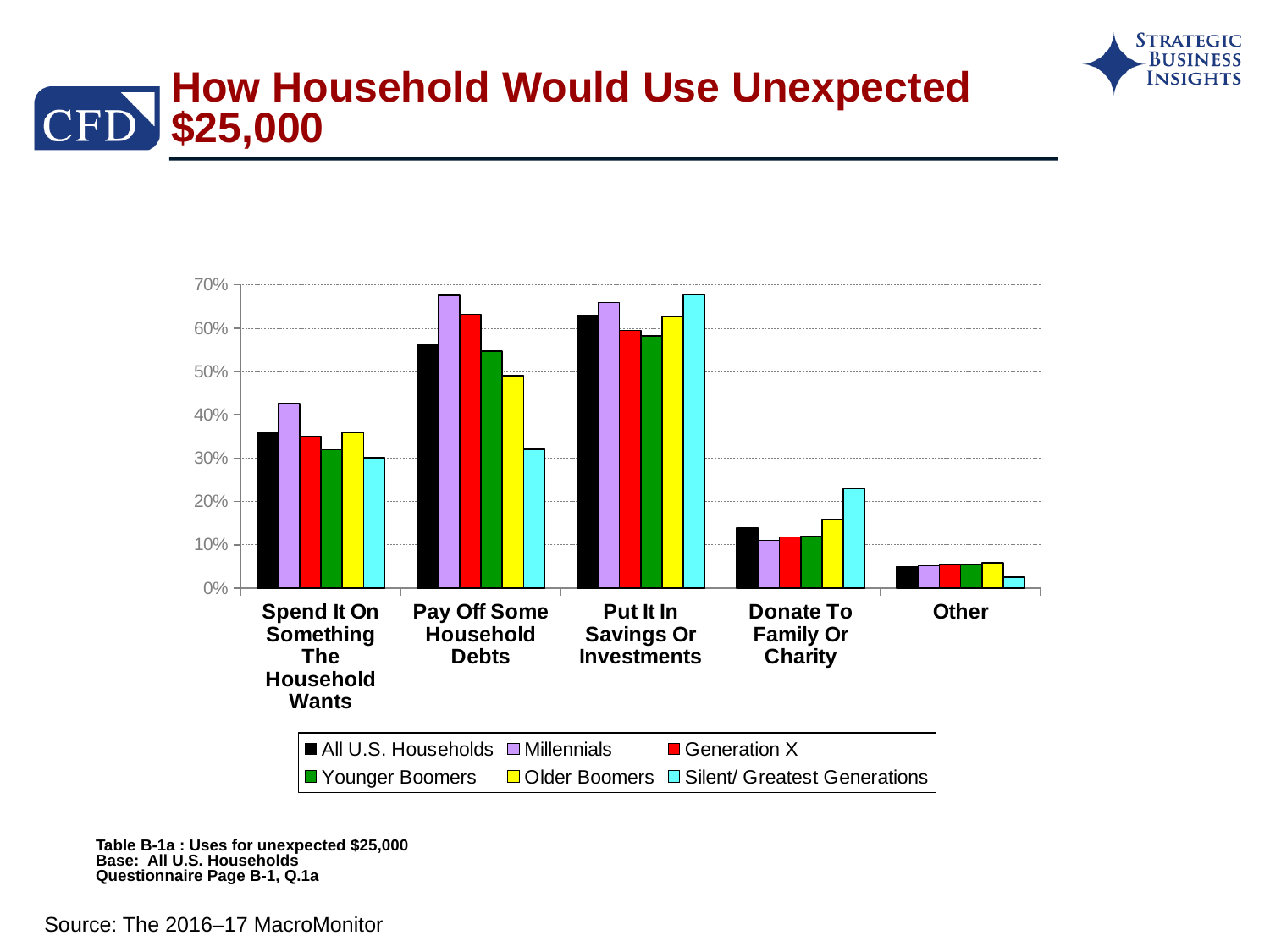
Is the value for Silent/ Greatest Generations in the 'Pay Off Some Household Debts' category greater or less than 40%? less Which series has the lowest value in the 'Pay Off Some Household Debts' category? Silent/ Greatest Generations What is the title of the chart on the slide? How Household Would Use Unexpected $25,000 In the 'Spend It On Something The Household Wants' category, which is larger: the value for Millennials or for Silent/ Greatest Generations? Millennials Is the value for Silent/ Greatest Generations in the 'Donate To Family Or Charity' category greater or less than 20%? greater Which series has the highest value in the 'Spend It On Something The Household Wants' category? Millennials What kind of chart is shown on the slide? bar chart How many categories of uses for the unexpected $25,000 are shown on the x axis? 5 Is the value for Millennials in the 'Pay Off Some Household Debts' category greater or less than 60%? greater Which series has the highest value in the 'Donate To Family Or Charity' category? Silent/ Greatest Generations How many series does the legend list? 6